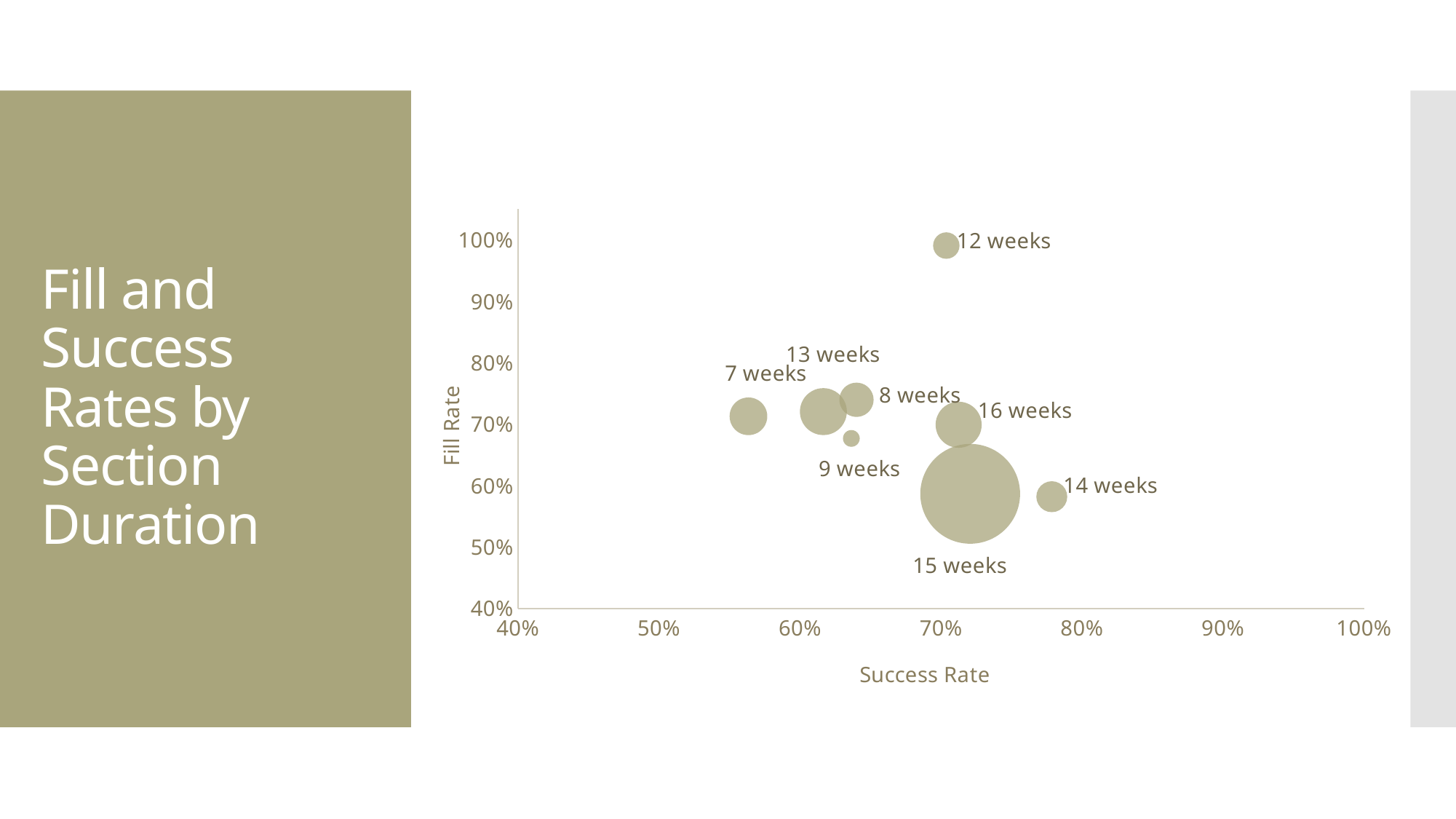
Which section duration has the lowest success rate? 7 weeks Which has the higher fill rate, 12 weeks or 15 weeks? 12 weeks Which section duration has the highest fill rate? 12 weeks Which section duration has the highest success rate? 14 weeks What kind of chart is shown on the slide? Bubble chart What is the label of the horizontal axis? Success Rate Which section duration is represented by the largest bubble? 15 weeks Is the success rate for 7 weeks greater or less than 60%? less Is the success rate for 14 weeks greater or less than 70%? greater Is the fill rate for 15 weeks greater or less than 70%? less How many section durations (bubbles) are plotted on the chart? 8